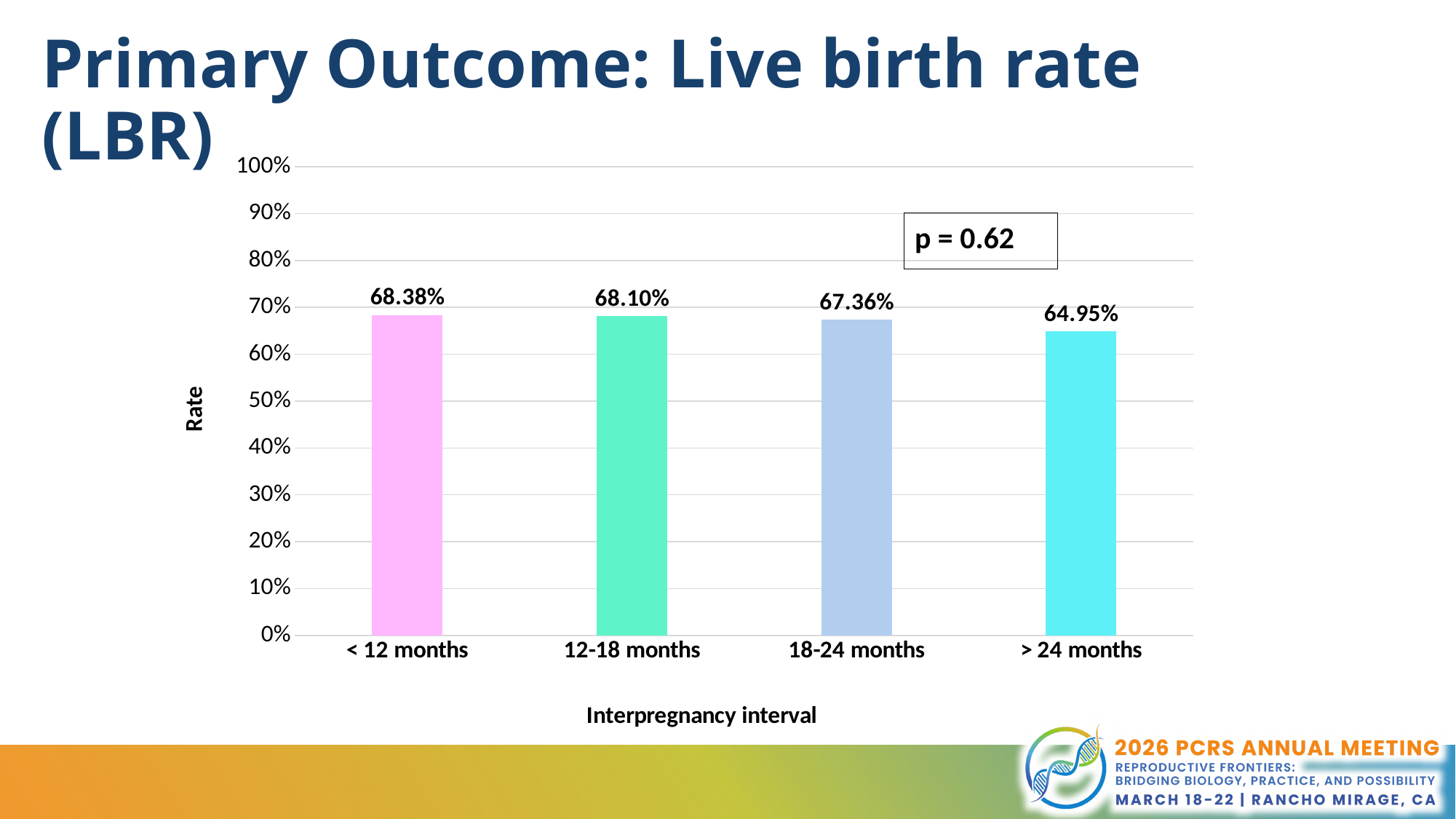
Do the live birth rates rise or fall as the interpregnancy interval increases along the x axis? Fall What is the live birth rate for the > 24 months interpregnancy interval? 64.95% What is the live birth rate for the 18-24 months interpregnancy interval? 67.36% Which has a higher live birth rate: 18-24 months or > 24 months? 18-24 months Which interpregnancy interval has the highest live birth rate? < 12 months What is the live birth rate for the < 12 months interpregnancy interval? 68.38% What is the difference in live birth rate between the < 12 months and > 24 months intervals? 3.43 percentage points Which interpregnancy interval has the lowest live birth rate? > 24 months What is the live birth rate for the 12-18 months interpregnancy interval? 68.10% What kind of chart is shown on the slide? Bar chart Is the live birth rate for > 24 months greater or less than 70%? less How many interpregnancy interval categories are shown in the chart? 4